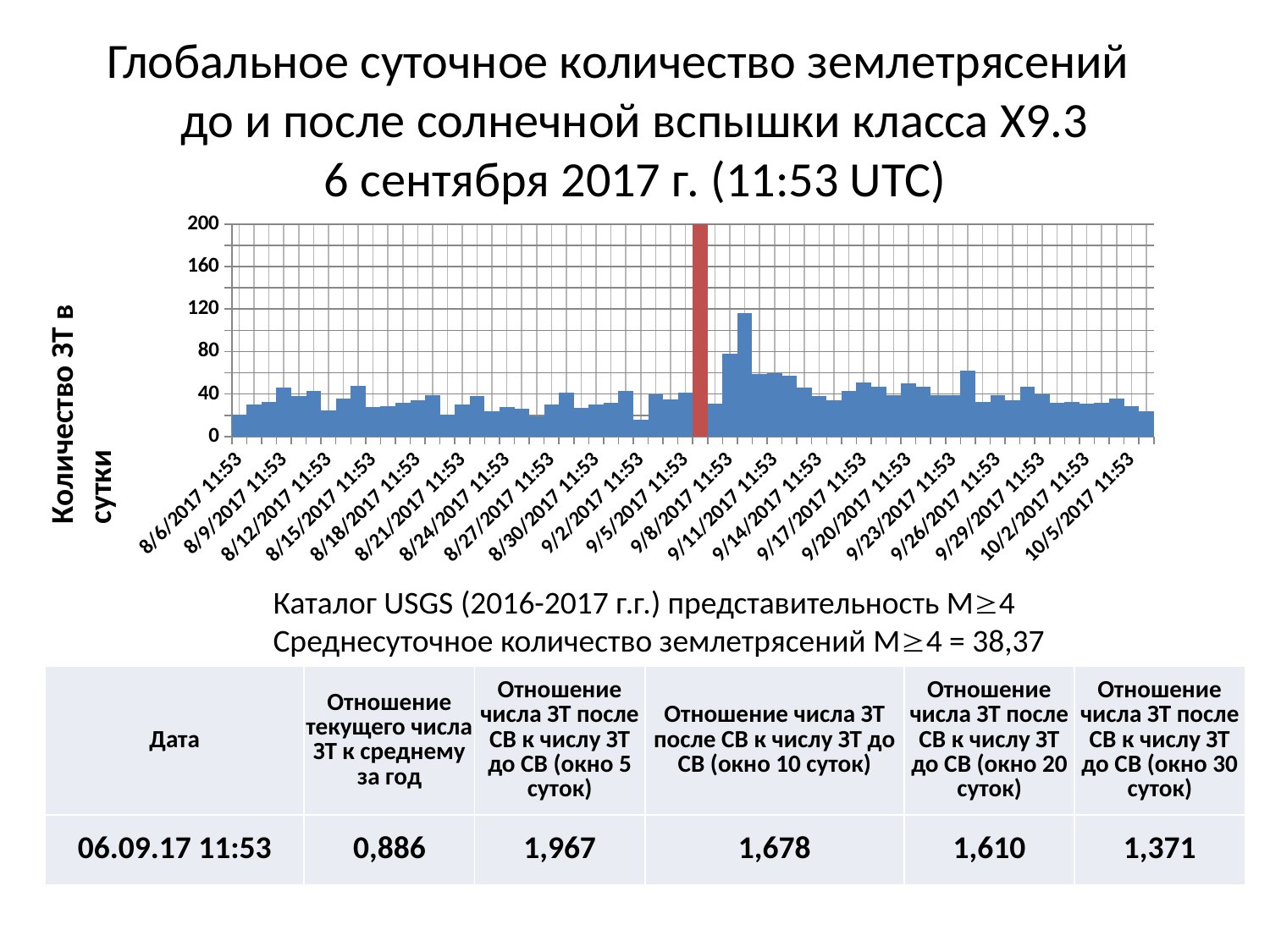
What kind of chart is shown on the slide? Bar chart What is the highest value shown on the y-axis of the chart? 200 Is the value for 8/6/2017 11:53 greater or less than 40? less Is the value for 10/5/2017 11:53 greater or less than 40? less Is the tallest bar located before or after the red vertical marker? After Is the tallest bar in the chart greater or less than 80? greater What is the y-axis title of the chart? Количество ЗТ в сутки What is the first date label on the x-axis of the chart? 8/6/2017 11:53 Which is larger: the bar immediately after the red marker or the bar immediately before it? The bar immediately before the red marker How many date labels are shown along the x-axis of the chart? 21